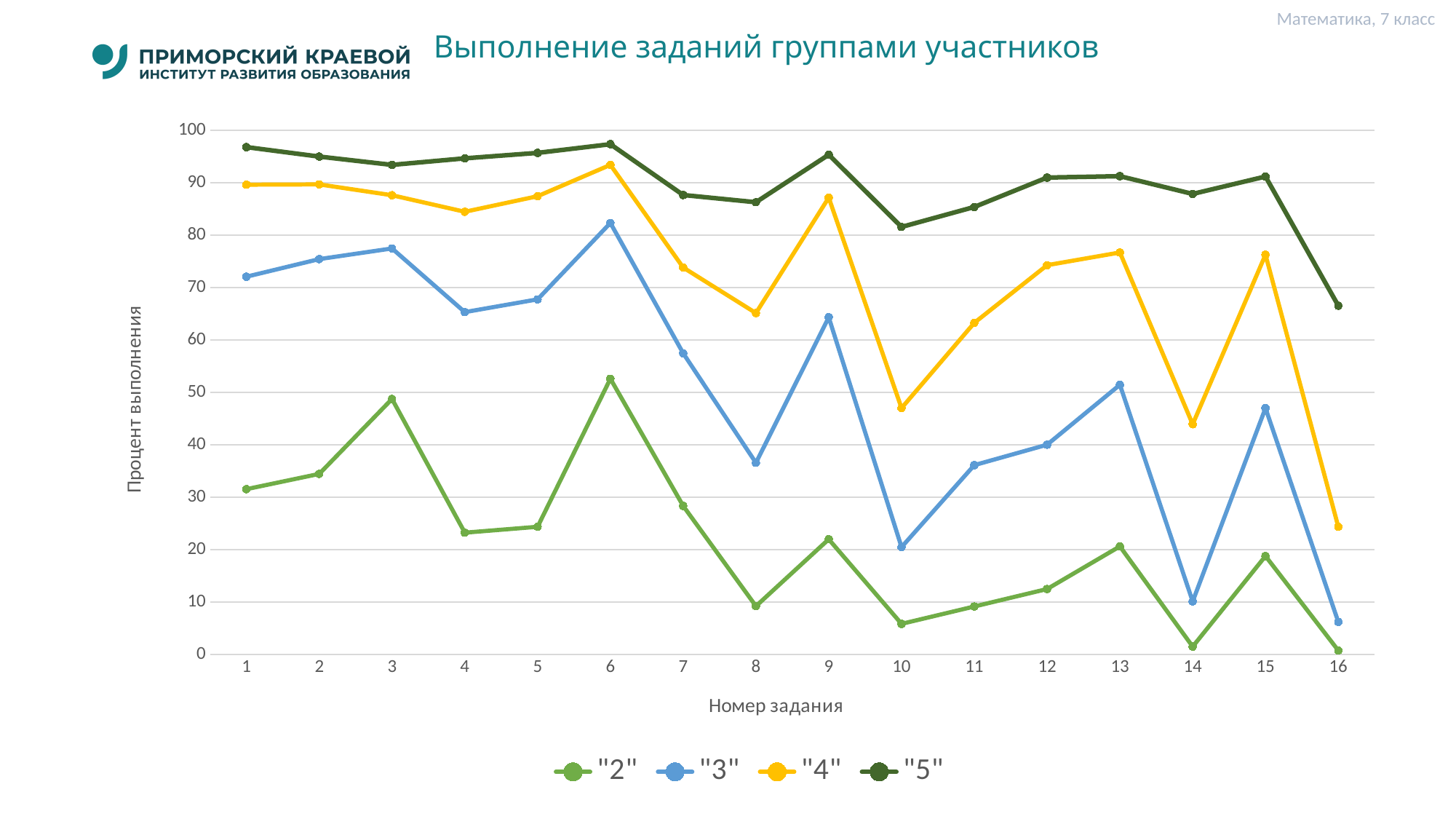
How many task numbers are plotted along the x axis? 16 What is the title of the chart? Выполнение заданий группами участников Is the value for series "5" at task 6 greater or less than 90? greater For series "4", which is larger: the value at task 9 or at task 10? task 9 For series "2", which task number has the highest value? 6 What kind of chart is shown on the slide? line chart Is the value for series "4" at task 14 greater or less than 50? less For series "5", which task number has the lowest value? 16 Is the value for series "2" at task 16 greater or less than 10? less For series "3", which task number has the lowest value? 16 How many series does the legend list? 4 What is the label of the vertical axis? Процент выполнения